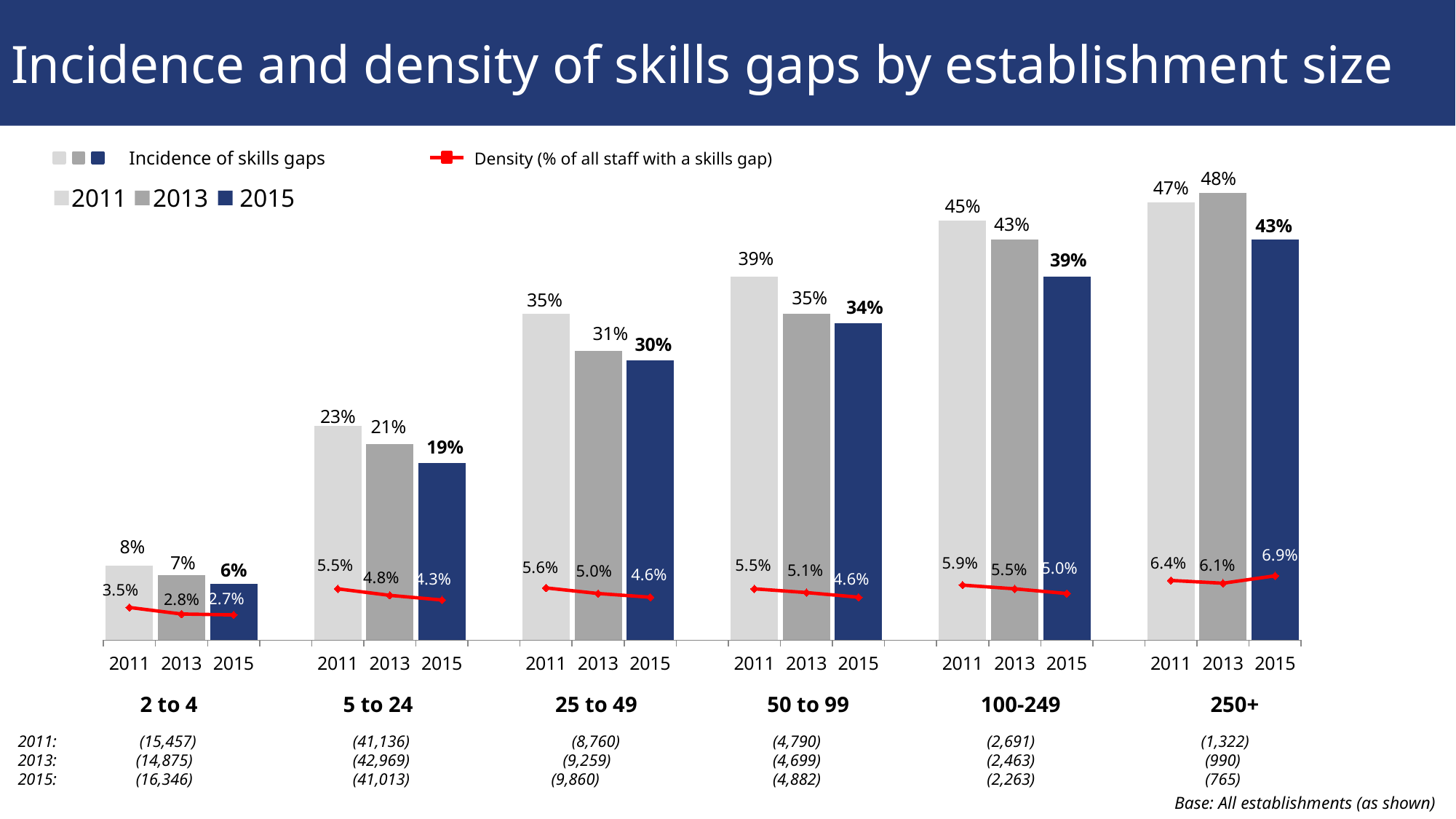
What is the density of skills gaps (% of all staff with a skills gap) for establishments with 5 to 24 staff in 2013? 4.8% Does the 2015 incidence of skills gaps rise or fall as establishment size increases from 2 to 4 up to 250+? Rise Which establishment size band has the lowest density of skills gaps in 2015? 2 to 4 What is the incidence of skills gaps for establishments with 2 to 4 staff in 2011? 8% What type of chart is used to show the incidence of skills gaps? Bar chart How many years does the legend list for incidence of skills gaps? 3 Is the 2013 incidence of skills gaps higher for establishments with 50 to 99 staff or 100-249 staff? 100-249 What is the incidence of skills gaps for establishments with 250+ staff in 2015? 43% What is the difference between the 2011 and 2015 incidence of skills gaps for establishments with 25 to 49 staff? 5 percentage points Which establishment size band has the highest incidence of skills gaps in 2015? 250+ How many establishment size bands are shown on the chart? 6 What colour is the line showing density of skills gaps? Red